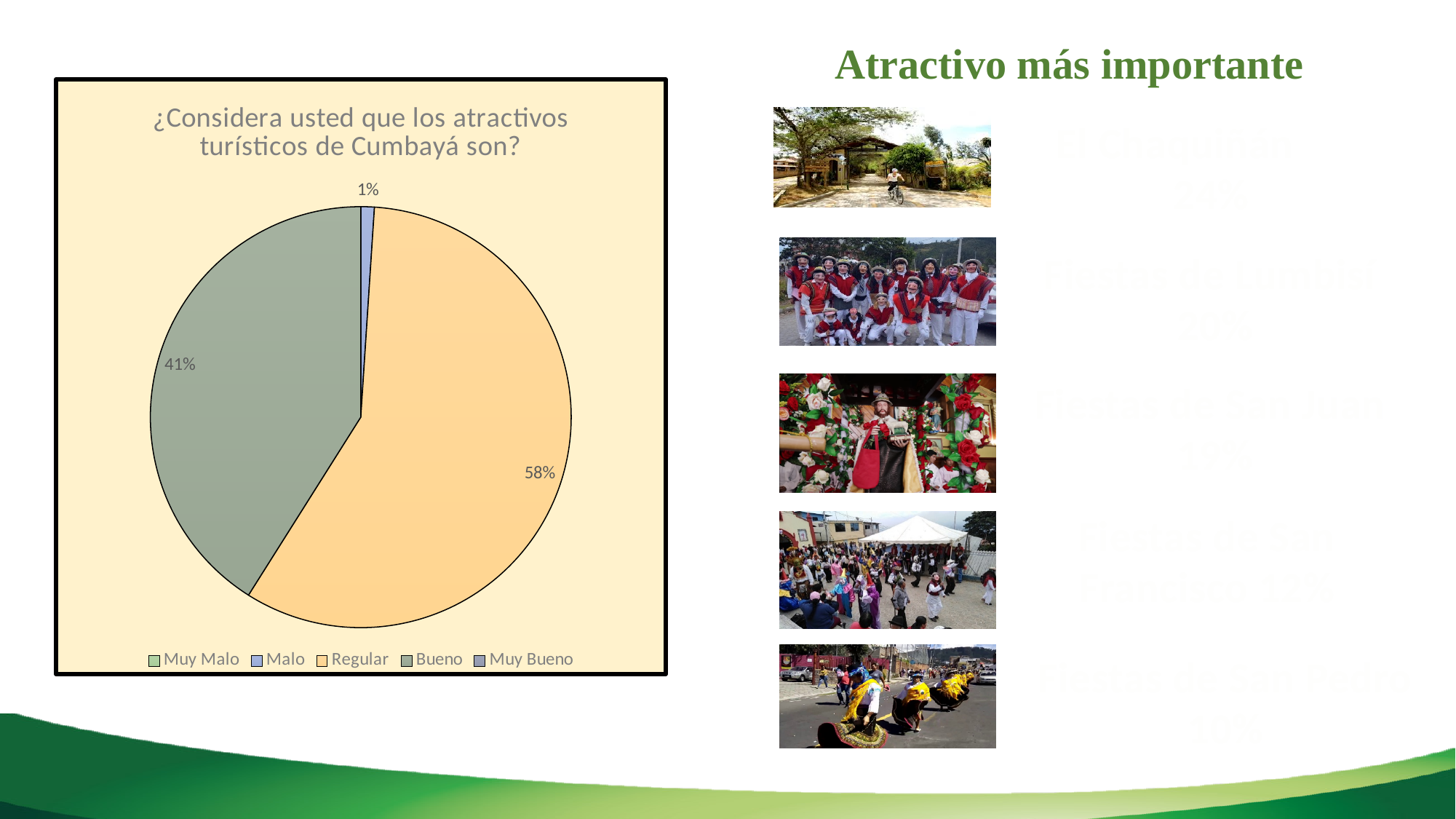
What type of chart is shown on the slide? pie chart Which of the visible slices in the pie chart is the smallest? Malo What is the difference in percentage points between the Regular and Bueno slices? 17 What percentage of the pie chart corresponds to Regular? 58% Which slice is larger, Bueno or Regular? Regular Which legend entry is shown in orange in the pie chart? Regular What percentage of the pie chart corresponds to Bueno? 41% What is the title of the pie chart? ¿Considera usted que los atractivos turísticos de Cumbayá son? How many slices with visible data labels does the pie chart have? 3 How many entries does the legend of the pie chart list? 5 Which category has the largest slice in the pie chart? Regular What percentage of the pie chart corresponds to Malo? 1%